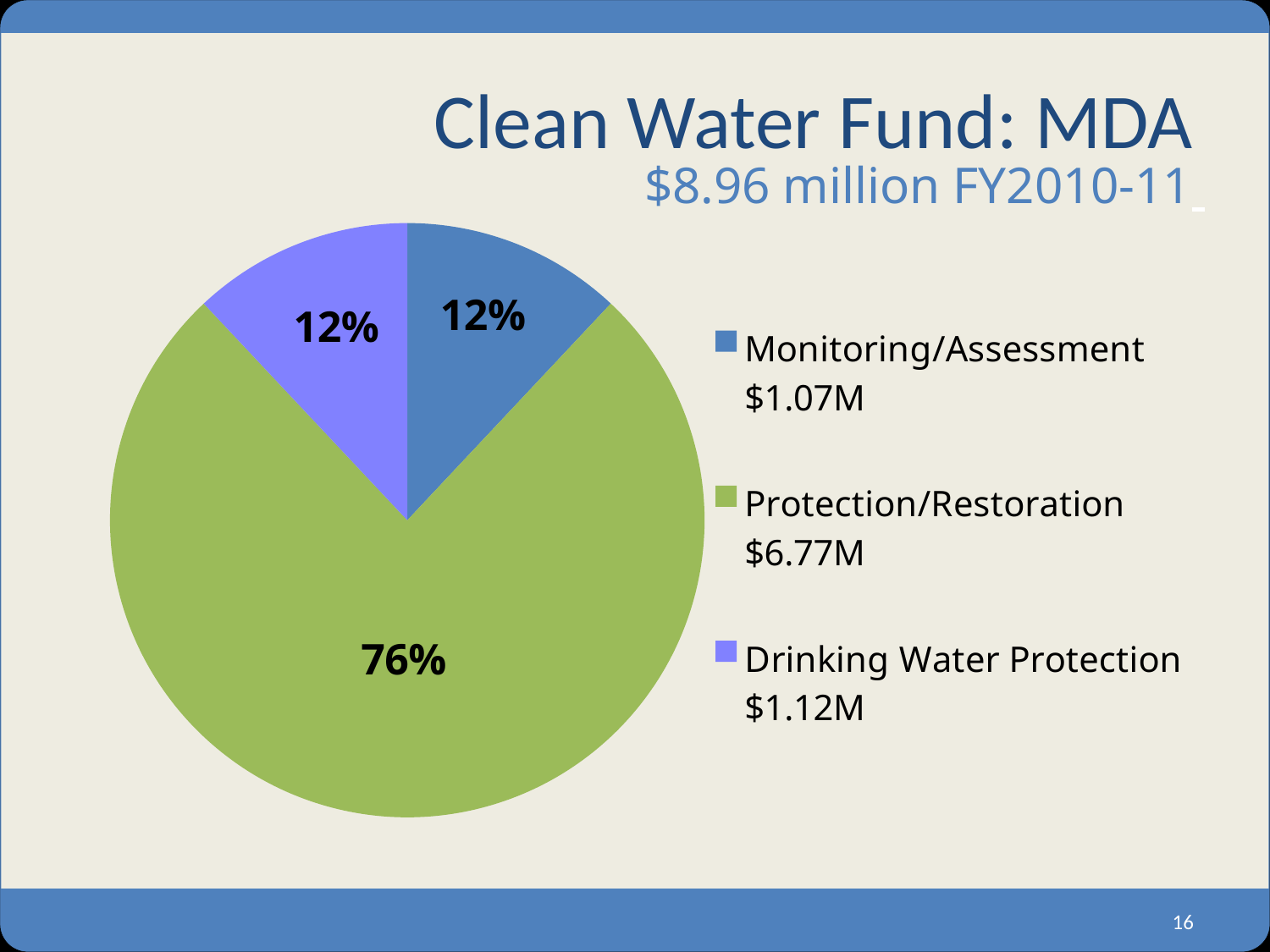
What percentage of the pie is Drinking Water Protection? 12% How many percentage points larger is the Protection/Restoration share than the Drinking Water Protection share? 64 Which category has the smallest dollar amount? Monitoring/Assessment Which category receives the largest share of the fund? Protection/Restoration What dollar amount is shown for Monitoring/Assessment? $1.07M What total amount for FY2010-11 is stated in the slide subtitle? $8.96 million What percentage of the Clean Water Fund goes to Protection/Restoration? 76% What dollar amount is shown for Drinking Water Protection? $1.12M How many slices does the pie chart have? 3 What dollar amount is shown for Protection/Restoration? $6.77M Which has the larger dollar amount, Drinking Water Protection or Monitoring/Assessment? Drinking Water Protection What type of chart is shown on the slide? Pie chart